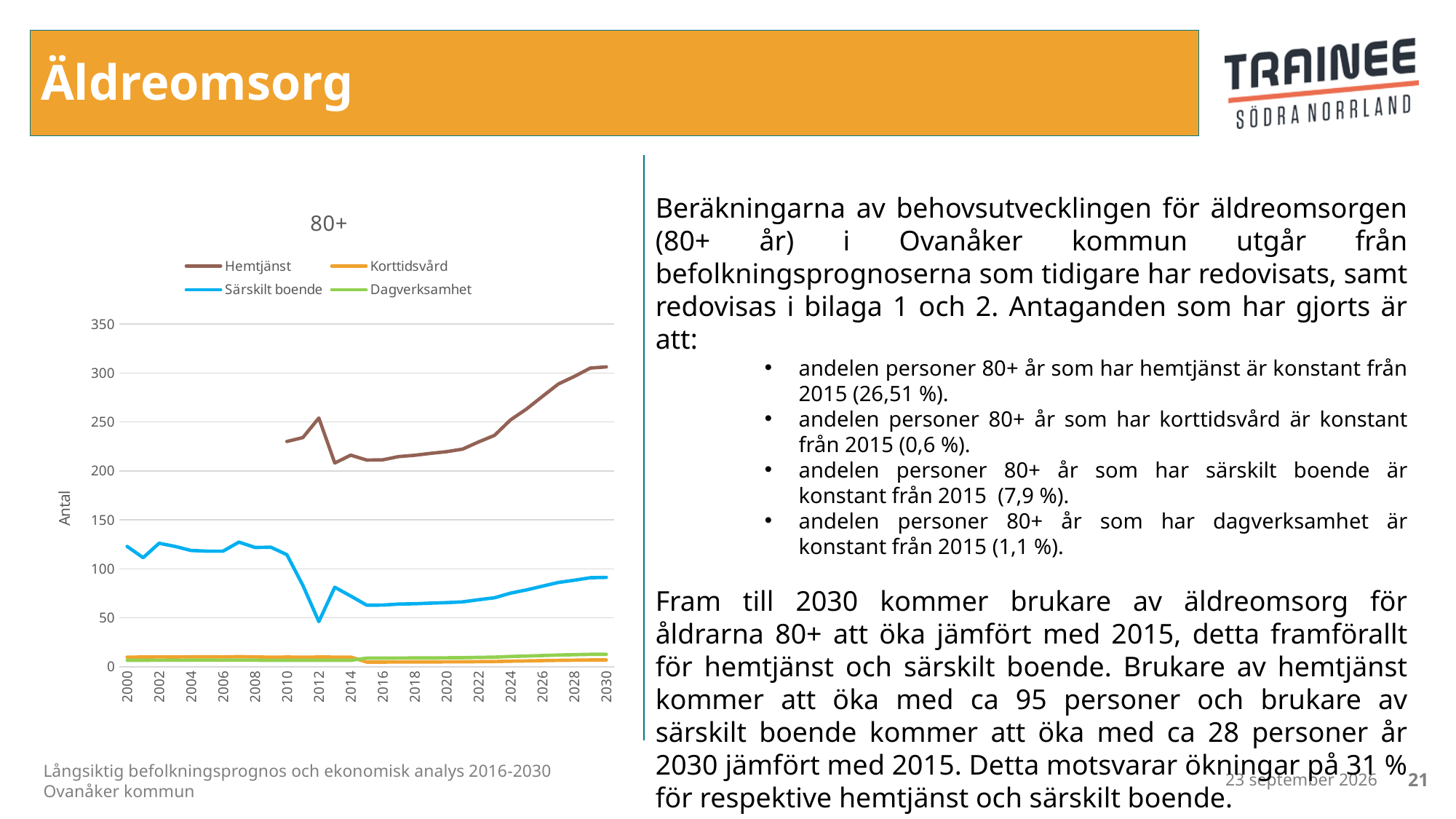
Which series has the higher value in 2030, Hemtjänst or Särskilt boende? Hemtjänst What label is shown on the vertical axis of the chart? Antal What is the title of the chart? 80+ Does the Hemtjänst line rise or fall between 2016 and 2030? rise Is the value for Särskilt boende in 2000 greater or less than 100? greater Is the value for Särskilt boende in 2030 greater or less than 100? less How many year labels are shown on the x axis of the chart? 16 How many series does the legend of the chart list? 4 What kind of chart is shown on the slide? line chart Is the value for Hemtjänst in 2016 greater or less than 250? less